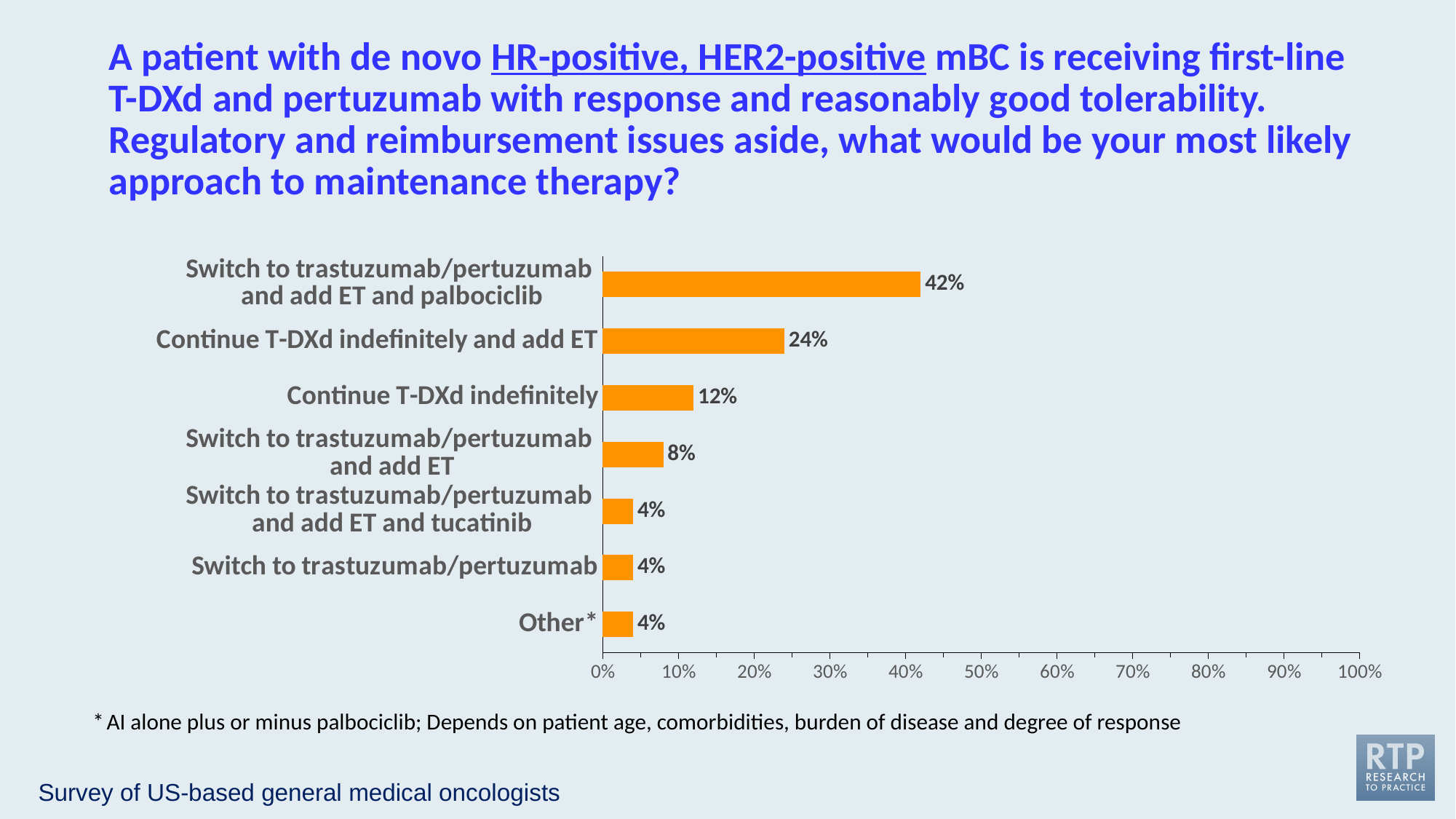
What is the value for "Switch to trastuzumab/pertuzumab and add ET"? 8% What percentage chose "Other"? 4% Which is larger: the value for "Continue T-DXd indefinitely" or the value for "Switch to trastuzumab/pertuzumab and add ET"? Continue T-DXd indefinitely What is the value for "Continue T-DXd indefinitely and add ET"? 24% What percentage chose "Continue T-DXd indefinitely"? 12% What is the difference between the values for "Switch to trastuzumab/pertuzumab and add ET and palbociclib" and "Continue T-DXd indefinitely and add ET"? 18% What percentage of respondents chose "Switch to trastuzumab/pertuzumab and add ET and palbociclib"? 42% How many response options are shown in the chart? 7 Which response option has the highest percentage? Switch to trastuzumab/pertuzumab and add ET and palbociclib What type of chart is shown on the slide? Bar chart How many response options have a value of 4%? 3 What is the maximum value shown on the x axis? 100%